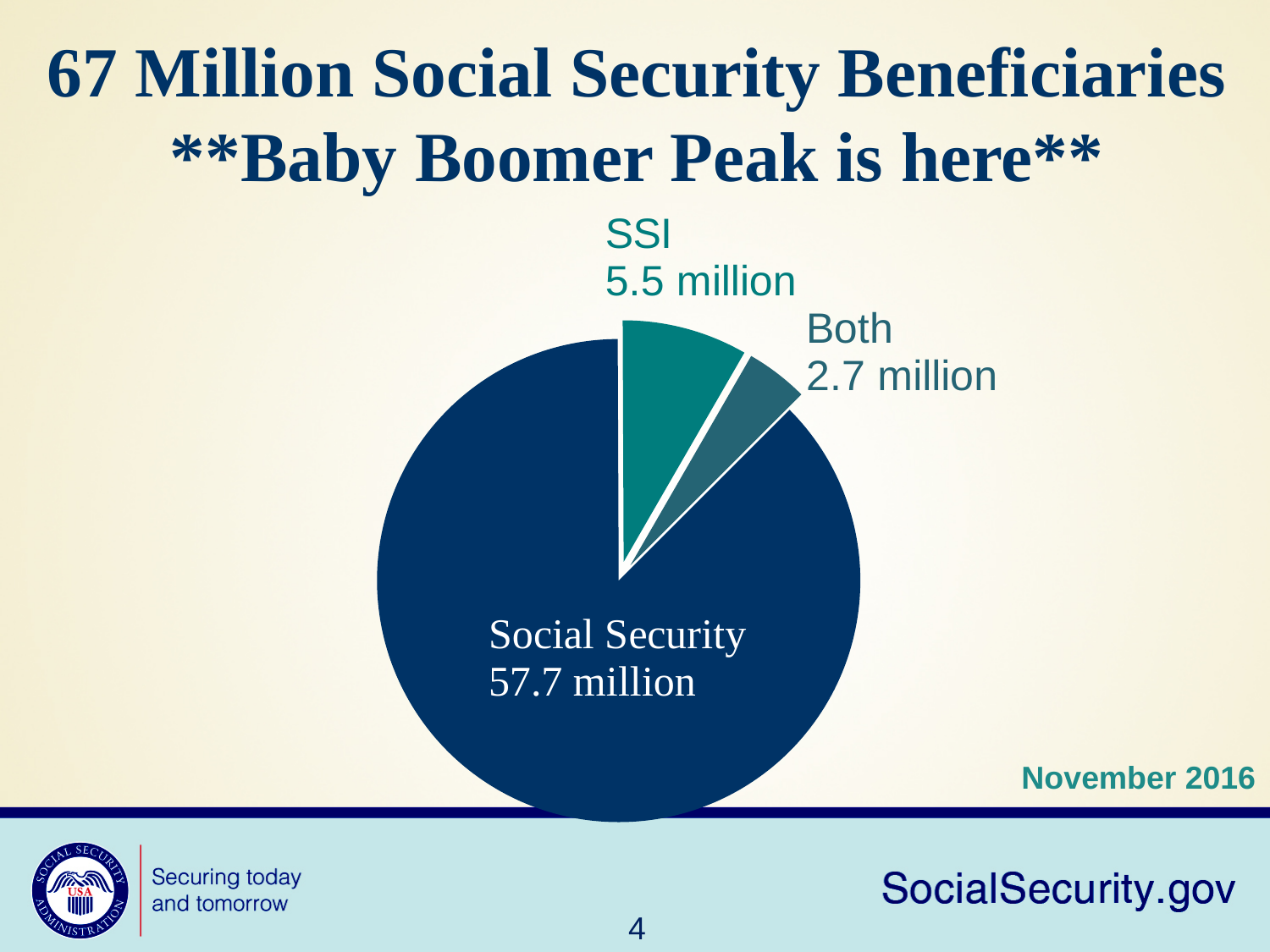
Which slice of the pie chart is the largest? Social Security What is the value shown for SSI? 5.5 million Which is larger, SSI or Both? SSI What is the difference between the SSI value and the Both value? 2.8 million How many slices does the pie chart have? 3 What is the title of the slide containing the pie chart? 67 Million Social Security Beneficiaries **Baby Boomer Peak is here** What date is printed below the pie chart? November 2016 What is the value shown for Social Security? 57.7 million What is the value shown for Both? 2.7 million Which slice of the pie chart is the smallest? Both What kind of chart is shown on the slide? Pie chart What is the difference between the Social Security value and the SSI value? 52.2 million